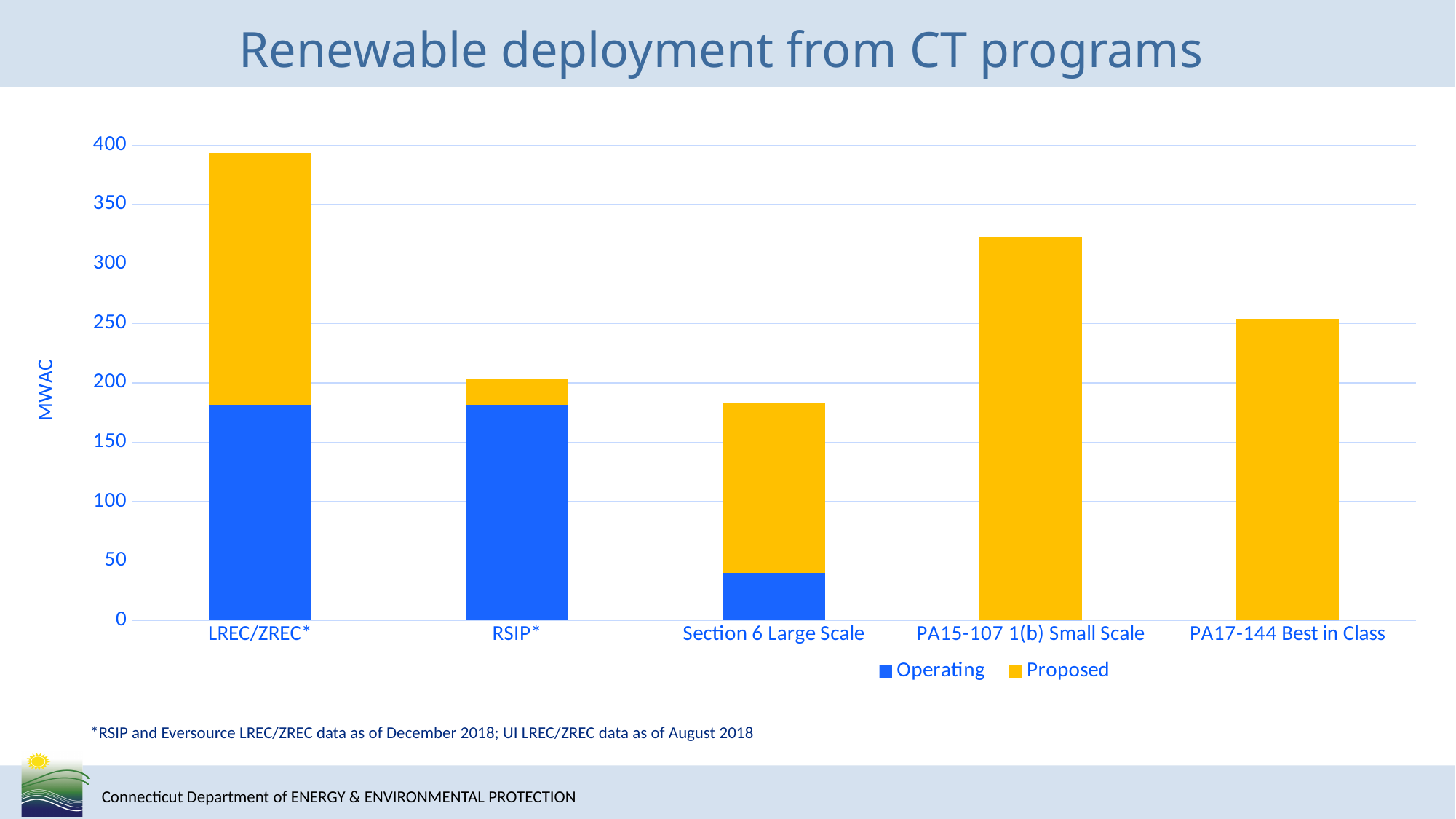
What kind of chart is shown on the slide? Stacked bar chart Which program has the highest total bar? LREC/ZREC* Which has the larger Operating value, RSIP* or Section 6 Large Scale? RSIP* Which program has the lowest total bar? Section 6 Large Scale How many program categories are shown on the x axis? 5 Is the Operating value for Section 6 Large Scale greater or less than 50? less Is the total value for LREC/ZREC* greater or less than 350? greater How many series does the legend list? 2 Which has the larger total bar, PA15-107 1(b) Small Scale or PA17-144 Best in Class? PA15-107 1(b) Small Scale Is the total value for PA15-107 1(b) Small Scale greater or less than 300? greater What is the label on the y axis? MWAC